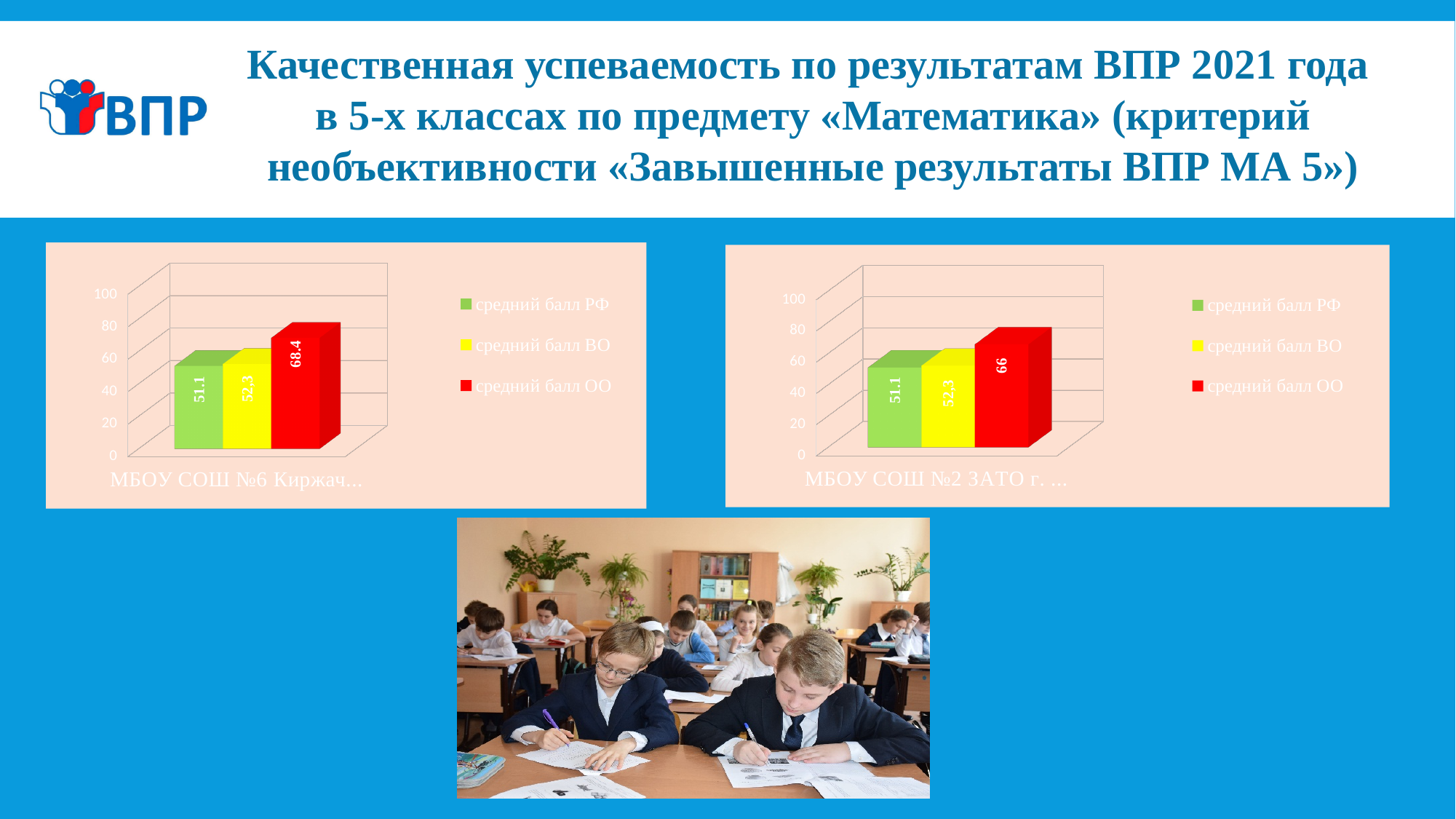
In the left chart, what colour is the bar for средний балл ОО? red In the right chart, what is the value for средний балл ВО? 52.3 In the left chart, which series has the highest value? средний балл ОО In the left chart, what is the value for средний балл ОО? 68.4 In the right chart, which series has the lowest value? средний балл РФ In the right chart, which is larger: средний балл ОО or средний балл ВО? средний балл ОО In the right chart, what is the value for средний балл ОО? 66 In the left chart, what is the value for средний балл РФ? 51.1 How many series does the legend of the left chart list? 3 In the left chart, what is the difference between средний балл ОО and средний балл ВО? 16.1 What kind of chart is the right chart? bar chart In the right chart, what is the difference between средний балл ОО and средний балл РФ? 14.9